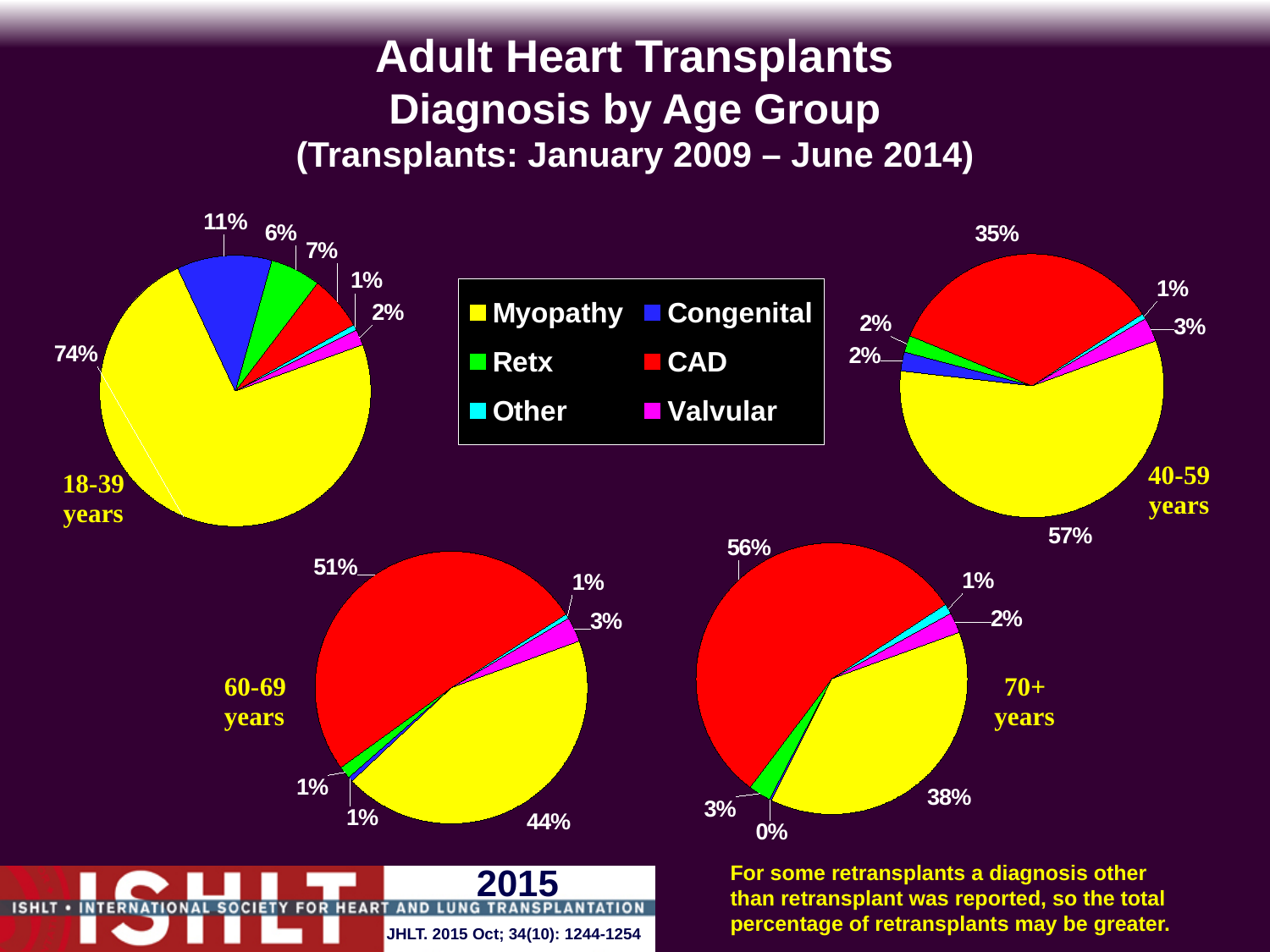
In the 60-69 years pie chart, which is larger, CAD or Myopathy? CAD In the 18-39 years pie chart, what share of transplants is Myopathy? 74% In the 70+ years pie chart, which diagnosis has the largest share? CAD In the 70+ years pie chart, what is the difference between the CAD share and the Myopathy share? 18% In the 40-59 years pie chart, what share of transplants is CAD? 35% In the 60-69 years pie chart, what share of transplants is Myopathy? 44% In the 18-39 years pie chart, what share of transplants is Congenital? 11% What type of chart is used to show diagnosis by age group on this slide? Pie chart How many diagnosis categories does the legend list? 6 In the 18-39 years pie chart, what is the difference between the Myopathy share and the Congenital share? 63% In the 40-59 years pie chart, which diagnosis has the smallest share? Other In the 70+ years pie chart, what share of transplants is Retx? 3%